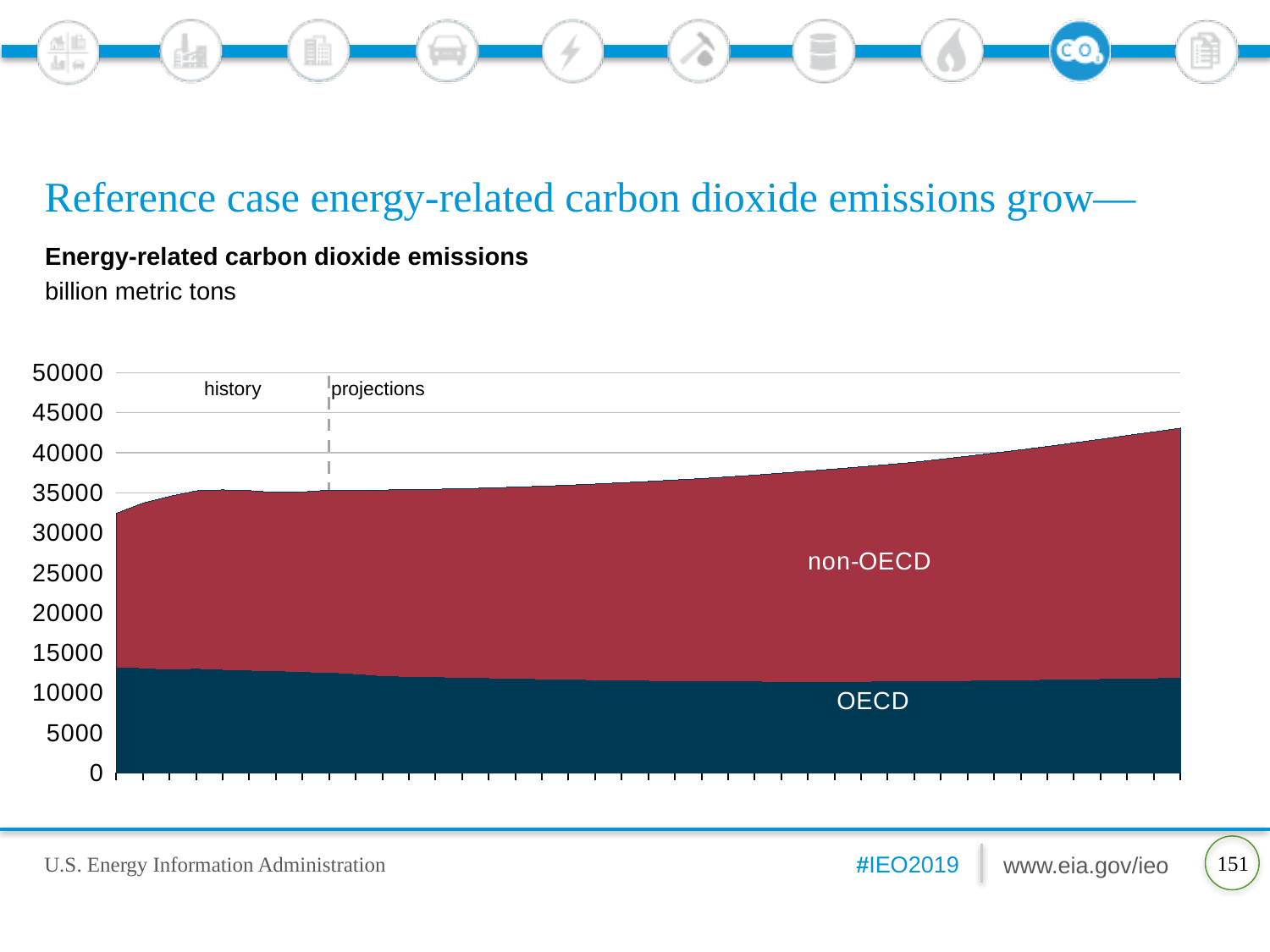
Does the OECD area rise or fall from the left end of the chart to the right end? fall Is the OECD value at the left end of the chart greater or less than 10000? greater Does the total of the stacked areas rise or fall from left to right across the chart? rise What is the highest value shown on the vertical axis? 50000 What kind of chart is shown on the slide? area chart How many series are plotted in the chart? 2 Which series is larger at the right end of the chart, OECD or non-OECD? non-OECD Is the total emissions value at the left end of the chart greater or less than 35000? less Which two series are labelled in the chart? non-OECD and OECD Is the OECD value at the right end of the chart greater or less than 15000? less What unit is given for the energy-related carbon dioxide emissions chart? billion metric tons